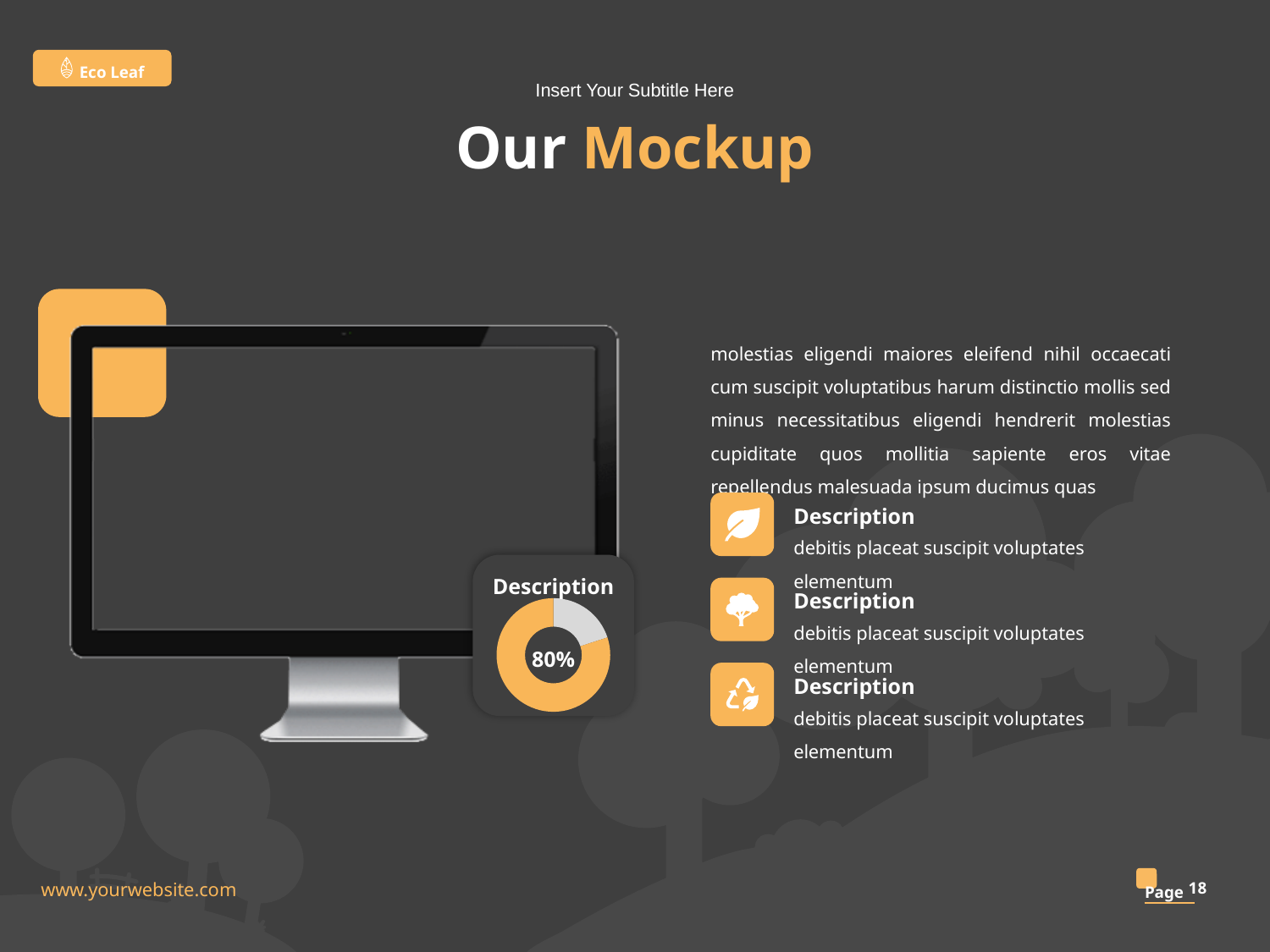
What colour is the largest segment of the doughnut chart? orange What value is printed in the centre of the doughnut chart? 80% What share of the doughnut chart does the orange segment represent? 80% Which segment of the doughnut chart is larger, the orange one or the grey one? orange What kind of chart is shown on the slide? doughnut chart How many segments does the doughnut chart have? 2 Is the value shown for the orange segment of the doughnut chart greater or less than 50%? greater What is the title shown above the doughnut chart? Description